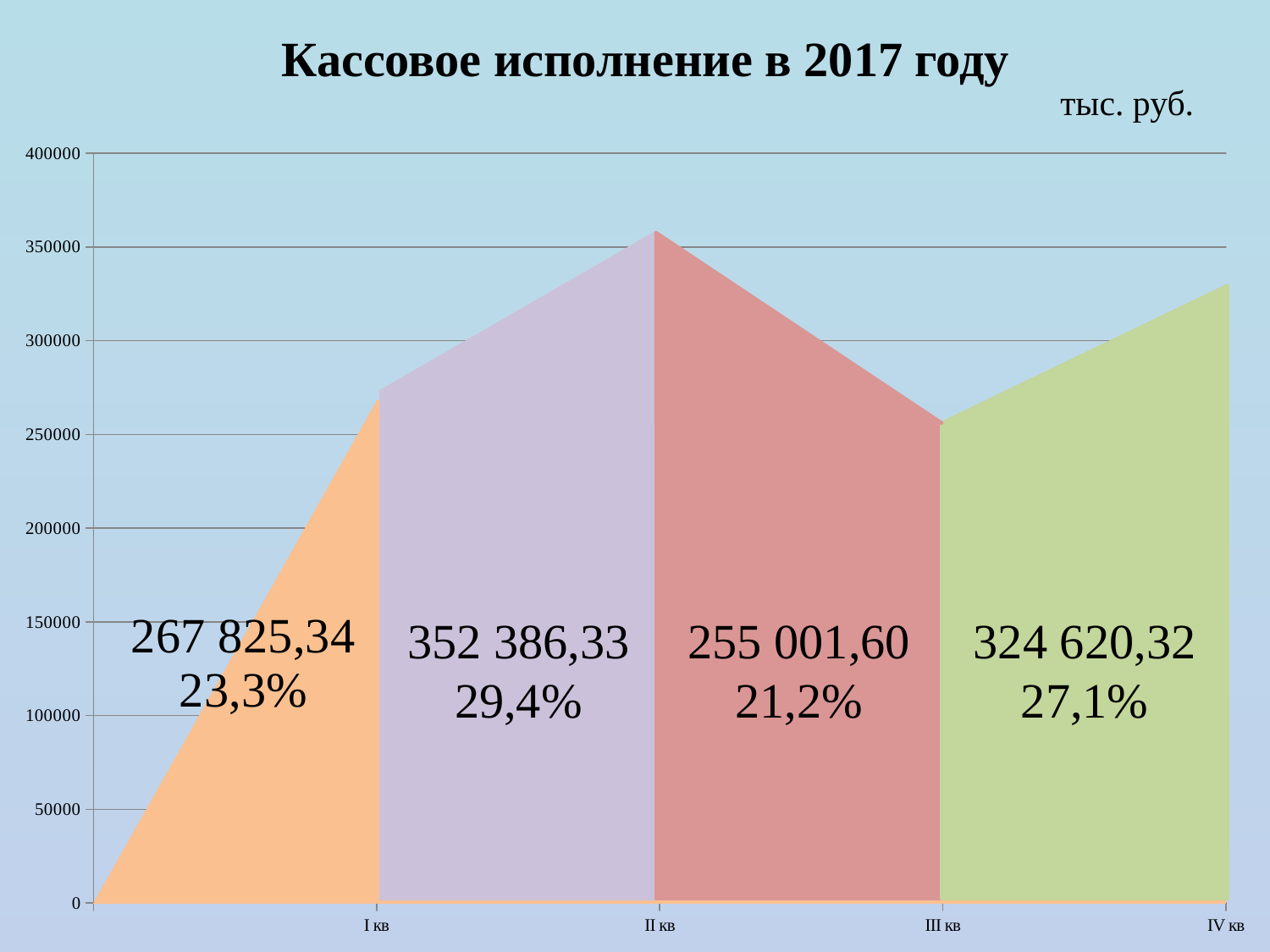
Is the value for III кв greater or less than 300000? less What is the title of the chart? Кассовое исполнение в 2017 году What is the value for I кв? 267 825,34 Which is larger, the value for I кв or the value for IV кв? IV кв How many quarters are plotted on the chart? 4 What percentage is shown for IV кв? 27,1% What is the difference between the values for II кв and III кв? 97 384,73 What kind of chart is shown on the slide? area chart What is the value for II кв? 352 386,33 What is the value for III кв? 255 001,60 Which quarter has the lowest value? III кв Which quarter has the highest value? II кв